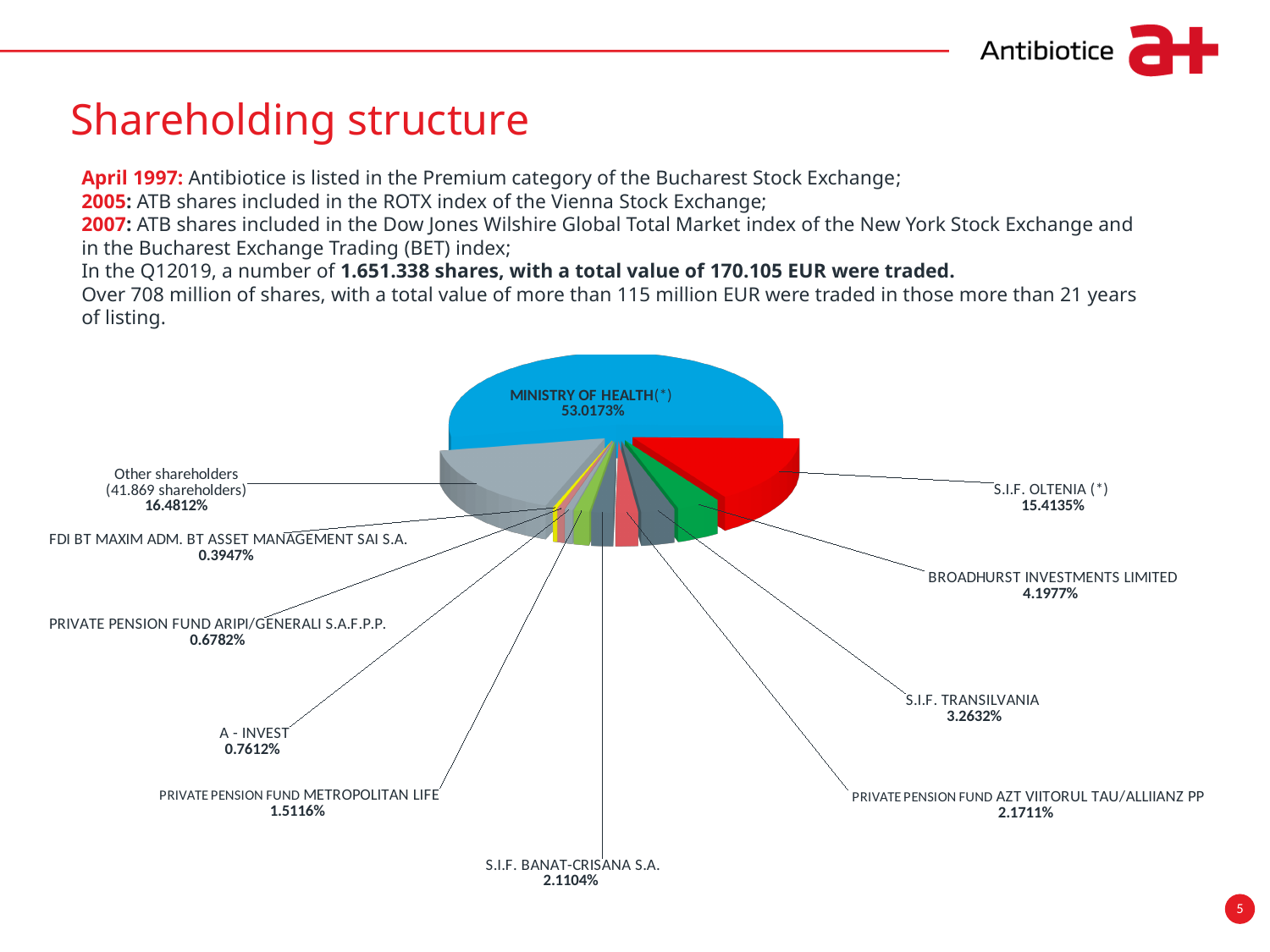
Which named shareholder has the smallest slice in the pie chart? FDI BT MAXIM ADM. BT ASSET MANAGEMENT SAI S.A. What share of the shareholding does the Ministry of Health hold? 53.0173% What percentage is shown for Broadhurst Investments Limited? 4.1977% What is the difference between the Ministry of Health's share and S.I.F. Oltenia's share? 37.6038% Which holds a larger share: S.I.F. Transilvania or Broadhurst Investments Limited? Broadhurst Investments Limited What share is held by Private Pension Fund Metropolitan Life? 1.5116% How many shareholders are included in the 'Other shareholders' slice? 41.869 shareholders What is the difference between the share of Other shareholders and that of S.I.F. Oltenia? 1.0677% What kind of chart is shown on the slide? Pie chart What is the percentage shown for S.I.F. Oltenia? 15.4135% Which shareholder holds the largest share in the pie chart? Ministry of Health How many slices does the pie chart have? 11